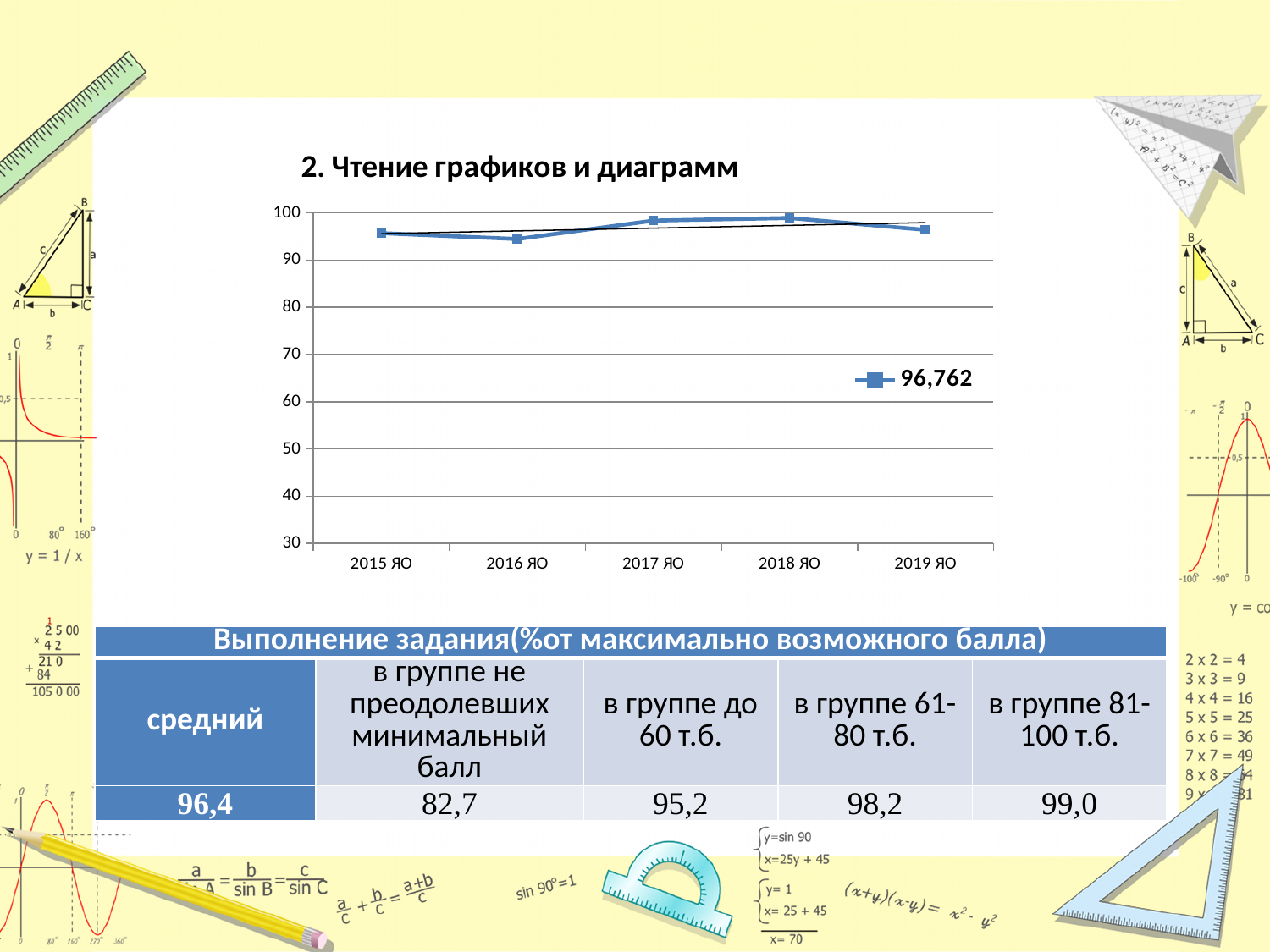
Which year has the lowest value on the line chart? 2016 ЯО Which is larger, the value for 2016 ЯО or the value for 2017 ЯО? 2017 ЯО Is the value for 2016 ЯО greater or less than 90? greater Is the value for 2018 ЯО greater or less than 100? less Is the value for 2019 ЯО greater or less than 90? greater What kind of chart is shown on the slide? line chart Which is larger, the value for 2018 ЯО or the value for 2019 ЯО? 2018 ЯО What is the legend entry shown for the series in the line chart? 96,762 How many series does the legend of the line chart list? 1 Do the values rise or fall from 2016 ЯО to 2018 ЯО? rise How many data points are plotted on the line chart? 5 What is the title above the line chart? 2. Чтение графиков и диаграмм